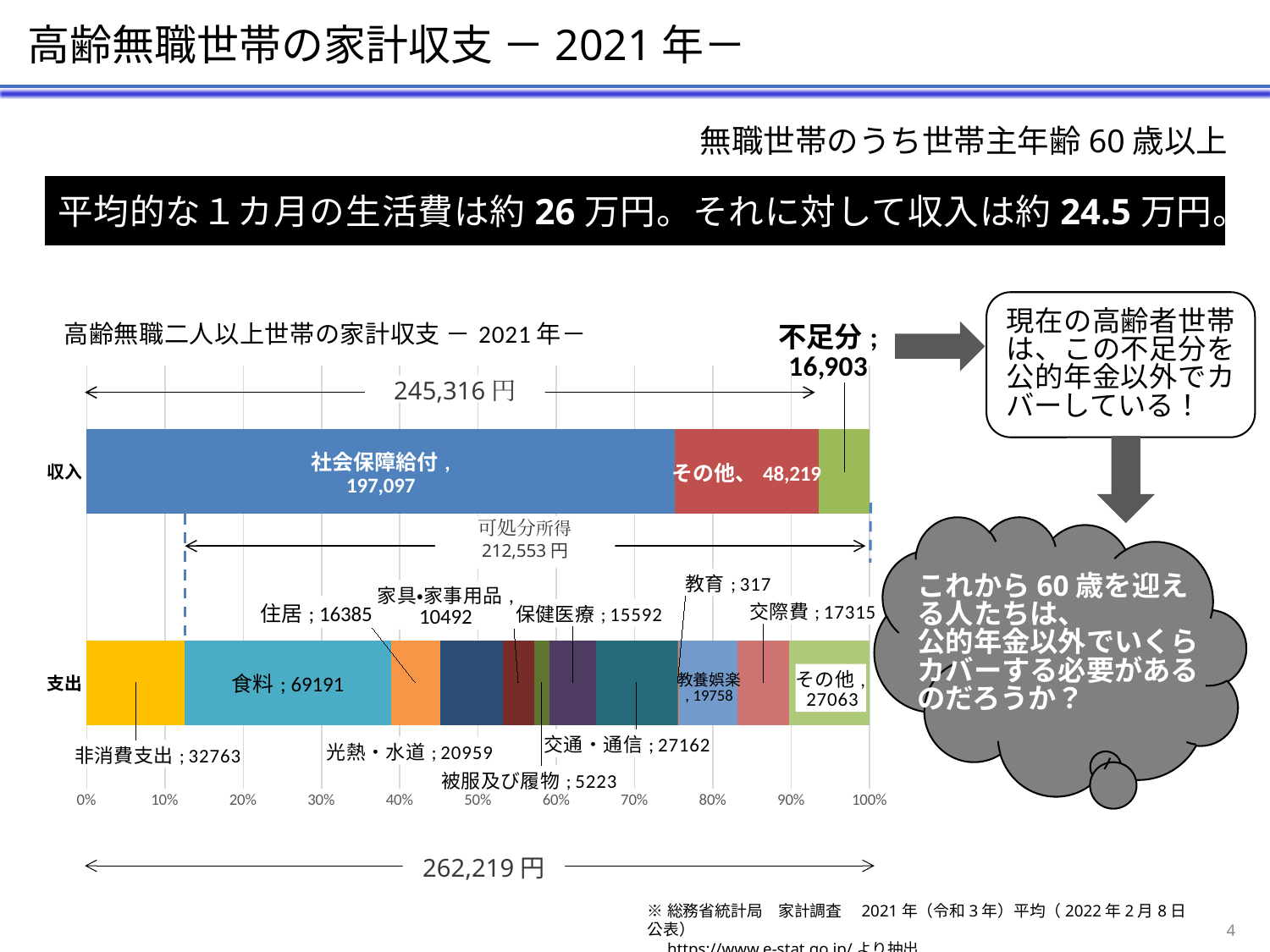
What is the value of 食料 in the 支出 bar? 69191 What is the value of 教育 in the 支出 bar? 317 What kind of chart is shown on the slide? stacked bar chart What is the difference between 社会保障給付 and その他 in the 収入 bar? 148,878 What is the value of 不足分 shown on the chart? 16,903 What is the value of 社会保障給付 in the 収入 bar? 197,097 Which segment of the 支出 bar has the largest value? 食料 What is the value of 非消費支出 in the 支出 bar? 32763 Which segment of the 支出 bar has the smallest value? 教育 Which is larger in the 支出 bar, 交通・通信 or 光熱・水道? 交通・通信 What is the value of その他 in the 収入 bar? 48,219 What is the total of the 支出 bar as shown on the slide? 262,219円